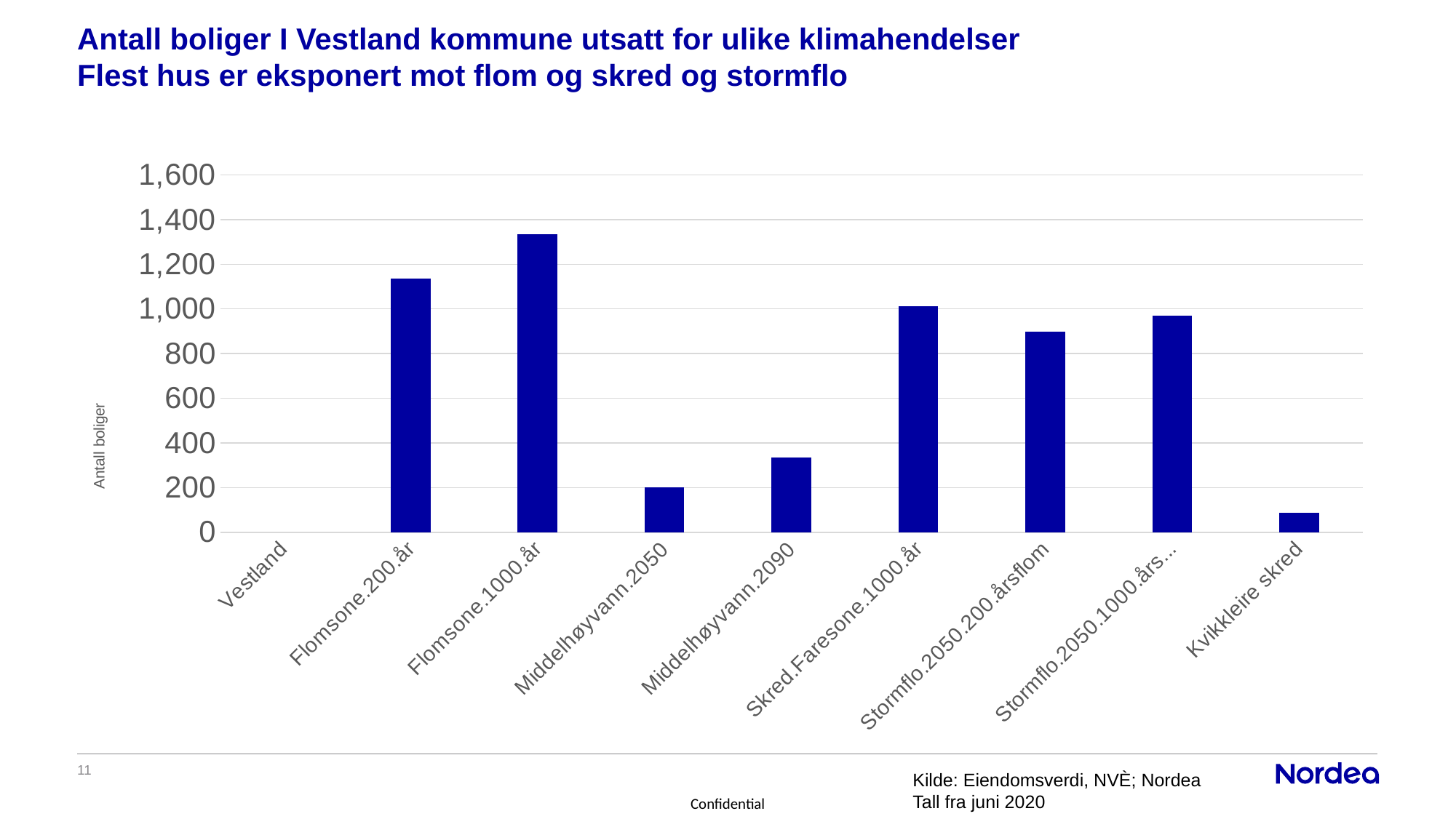
Is the value for Skred.Faresone.1000.år greater or less than 800? greater How many categories are shown on the x axis of the chart? 9 Which is larger, the value for Flomsone.1000.år or Flomsone.200.år? Flomsone.1000.år Which is larger, the value for Middelhøyvann.2050 or Middelhøyvann.2090? Middelhøyvann.2090 Is the value for Middelhøyvann.2090 greater or less than 400? less Is the value for Flomsone.200.år greater or less than 1,000? greater Excluding Vestland, which has no visible bar, which category has the lowest value? Kvikkleire skred What kind of chart is shown on the slide? Bar chart Which is larger, the value for Skred.Faresone.1000.år or Stormflo.2050.200.årsflom? Skred.Faresone.1000.år What is the label on the vertical axis of the chart? Antall boliger Which category has the highest value in the chart? Flomsone.1000.år